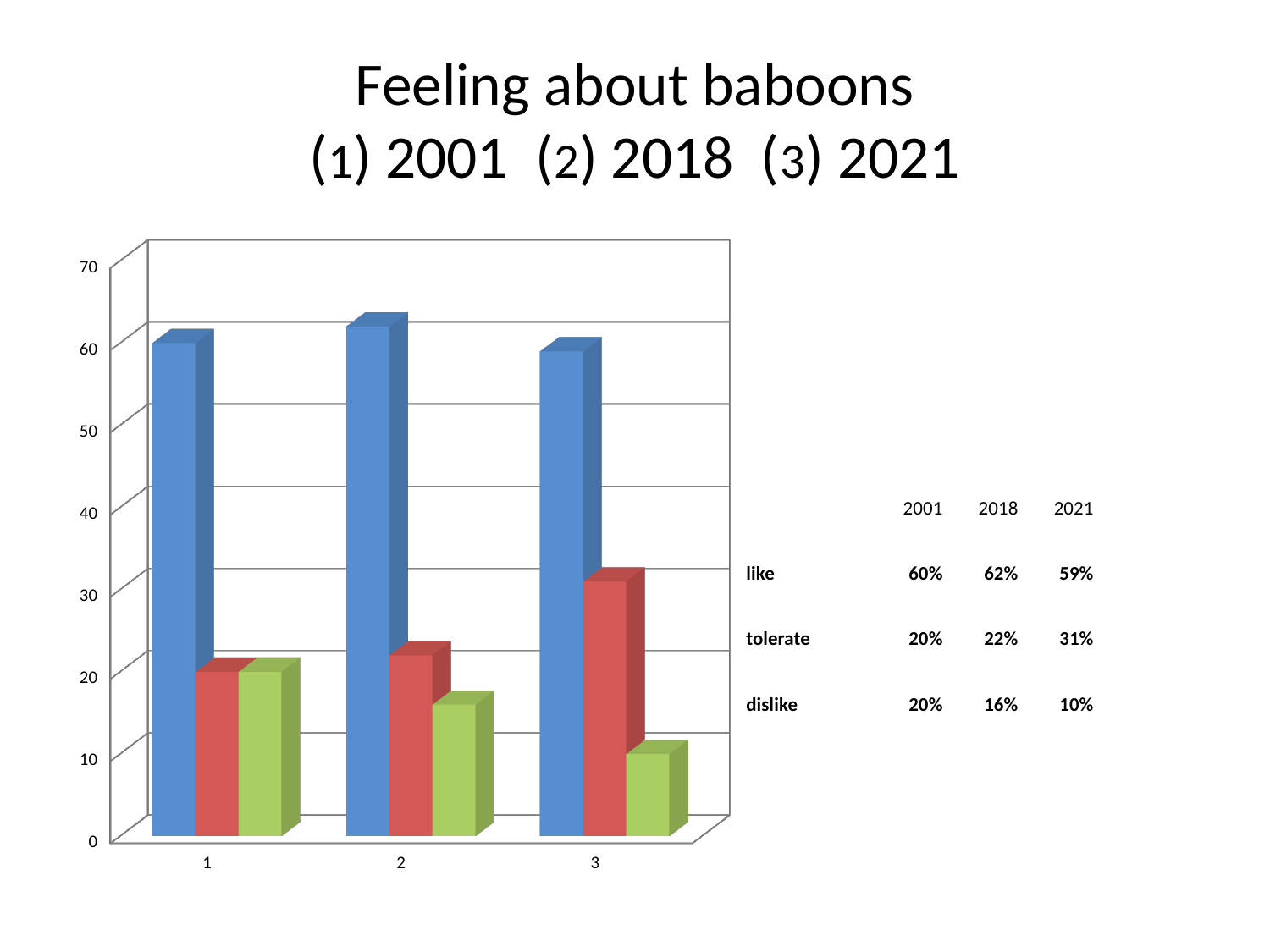
In which year was the 'like' percentage highest? 2018 How many categories are shown along the x axis of the chart? 3 What is the title of the chart on the slide? Feeling about baboons (1) 2001 (2) 2018 (3) 2021 Is the value of the blue bar for category 3 greater or less than 50? greater In 2018, which was larger: the 'tolerate' value or the 'dislike' value? tolerate According to the table beside the chart, what percentage of people said they like baboons in 2001? 60% Does the 'dislike' value rise or fall from category 1 to category 3? fall In which year was the 'dislike' percentage lowest? 2021 By how many percentage points did the 'tolerate' value increase from 2001 to 2021? 11% What is the 'tolerate' value for 2021 shown on the slide? 31% What is the 'dislike' value for 2018 shown on the slide? 16% What kind of chart is shown on the slide? bar chart